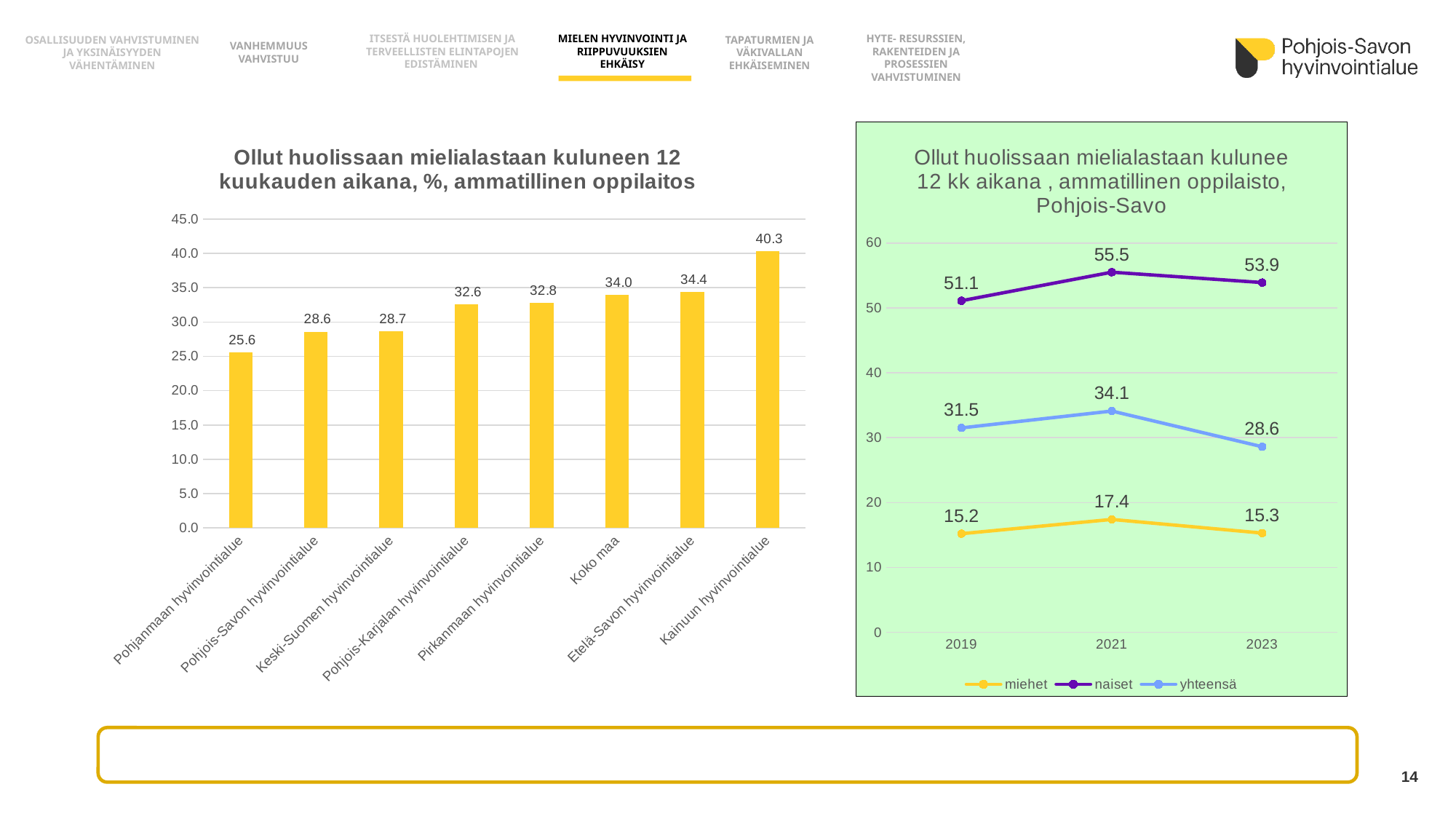
What kind of chart is the chart on the right (Pohjois-Savo)? line chart In the right line chart, which series is drawn in purple? naiset In the right line chart, does the yhteensä series rise or fall from 2021 to 2023? fall In the left bar chart, what is the value for Kainuun hyvinvointialue? 40.3 In the left bar chart, what is the value for Koko maa? 34.0 In the right line chart, what is the value for naiset in 2021? 55.5 In the right line chart, which is larger: yhteensä in 2019 or yhteensä in 2023? yhteensä in 2019 In the left bar chart, which category has the lowest value? Pohjanmaan hyvinvointialue In the left bar chart, how many categories are shown? 8 In the right line chart, what is the difference between naiset and miehet in 2023? 38.6 In the right line chart, how many series does the legend list? 3 In the left bar chart, what is the difference between Kainuun hyvinvointialue and Pohjanmaan hyvinvointialue? 14.7